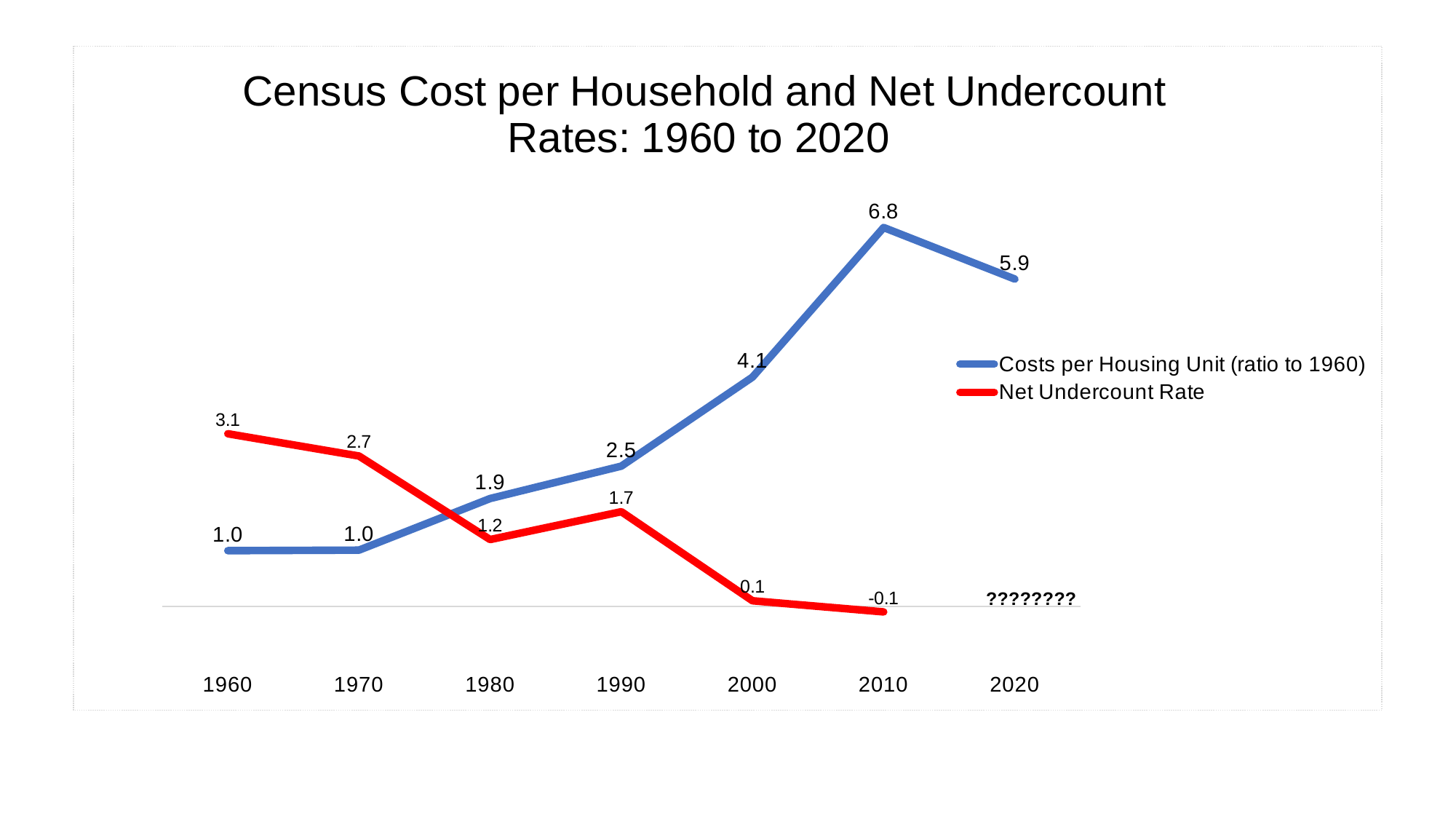
How many series does the legend list? 2 Which is larger in 1990: Costs per Housing Unit (ratio to 1960) or the Net Undercount Rate? Costs per Housing Unit (ratio to 1960) Does the Net Undercount Rate generally rise or fall from 1960 to 2010? Fall What kind of chart is this? Line chart What is the value of Costs per Housing Unit (ratio to 1960) in 2010? 6.8 How many years are shown on the x axis? 7 What is the value of Costs per Housing Unit (ratio to 1960) in 2020? 5.9 What is the difference between Costs per Housing Unit (ratio to 1960) in 2010 and in 2020? 0.9 In which year is the Net Undercount Rate lowest? 2010 In which year is Costs per Housing Unit (ratio to 1960) highest? 2010 What is the Net Undercount Rate in 1960? 3.1 What is the Net Undercount Rate in 2010? -0.1